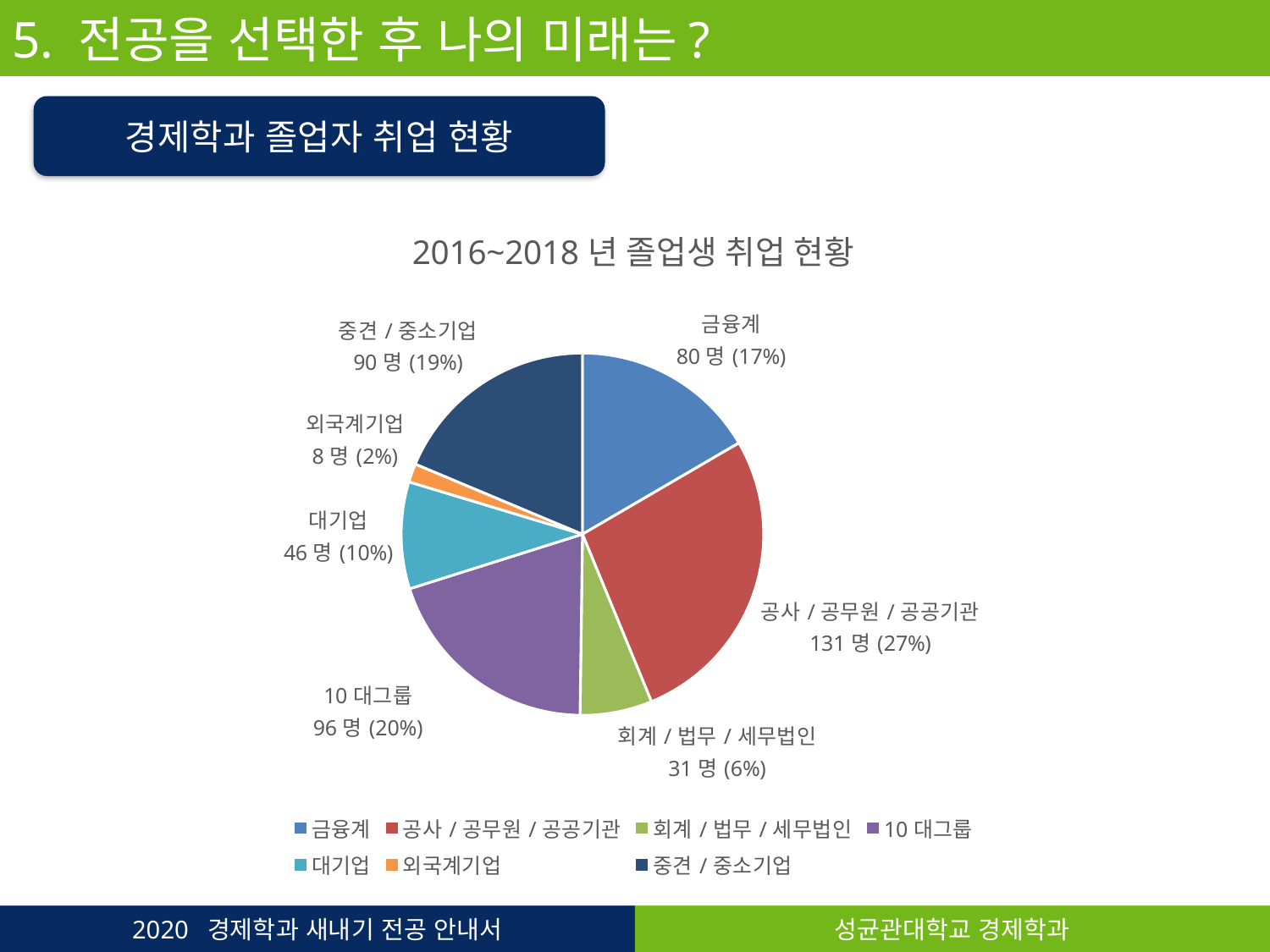
What is the value shown for 10 대그룹? 96 명 How many entries does the legend list? 7 How many graduates are in the 금융계 category? 80 명 What is the title of the chart? 2016~2018 년 졸업생 취업 현황 Which is larger, 대기업 or 회계 / 법무 / 세무법인? 대기업 Which category has the smallest slice? 외국계기업 What percentage share is shown for 중견 / 중소기업? 19% Which category has the largest slice? 공사 / 공무원 / 공공기관 What type of chart is shown on the slide? pie chart What is the difference in number of graduates between 공사 / 공무원 / 공공기관 and 금융계? 51 명 What share of the pie does 공사 / 공무원 / 공공기관 represent? 27% How many slices does the pie chart have? 7